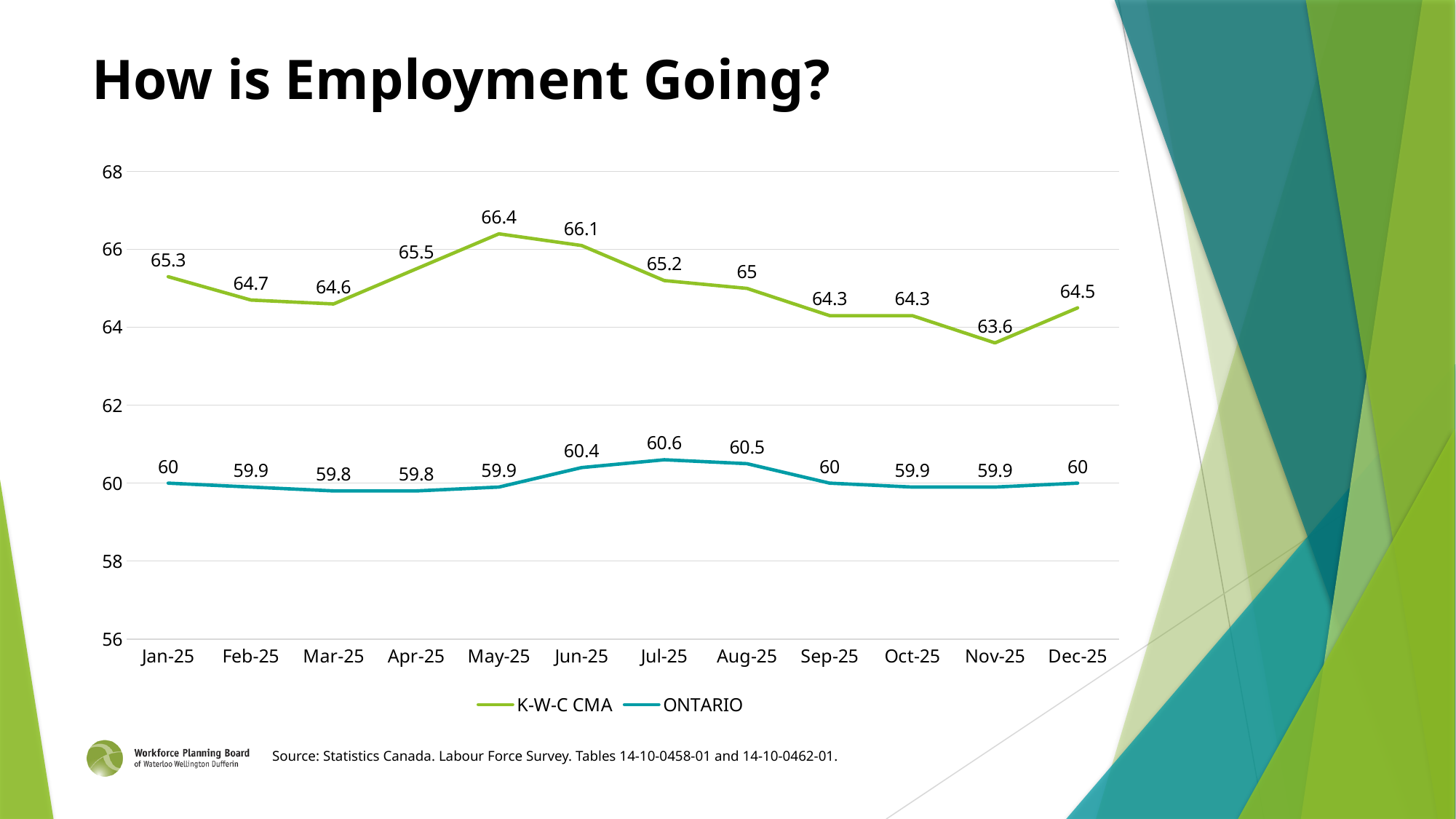
In which month is the K-W-C CMA value lowest? Nov-25 Which is larger in Nov-25, the K-W-C CMA value or the ONTARIO value? K-W-C CMA How many series does the legend list? 2 What is the K-W-C CMA value for May-25? 66.4 In which month is the K-W-C CMA value highest? May-25 In which month is the ONTARIO value highest? Jul-25 What is the ONTARIO value for Jul-25? 60.6 Does the K-W-C CMA value rise or fall from May-25 to Nov-25? Fall What is the K-W-C CMA value for Dec-25? 64.5 What kind of chart is shown on the slide? Line chart What is the difference between the K-W-C CMA and ONTARIO values in Jan-25? 5.3 How many months are shown on the x axis? 12